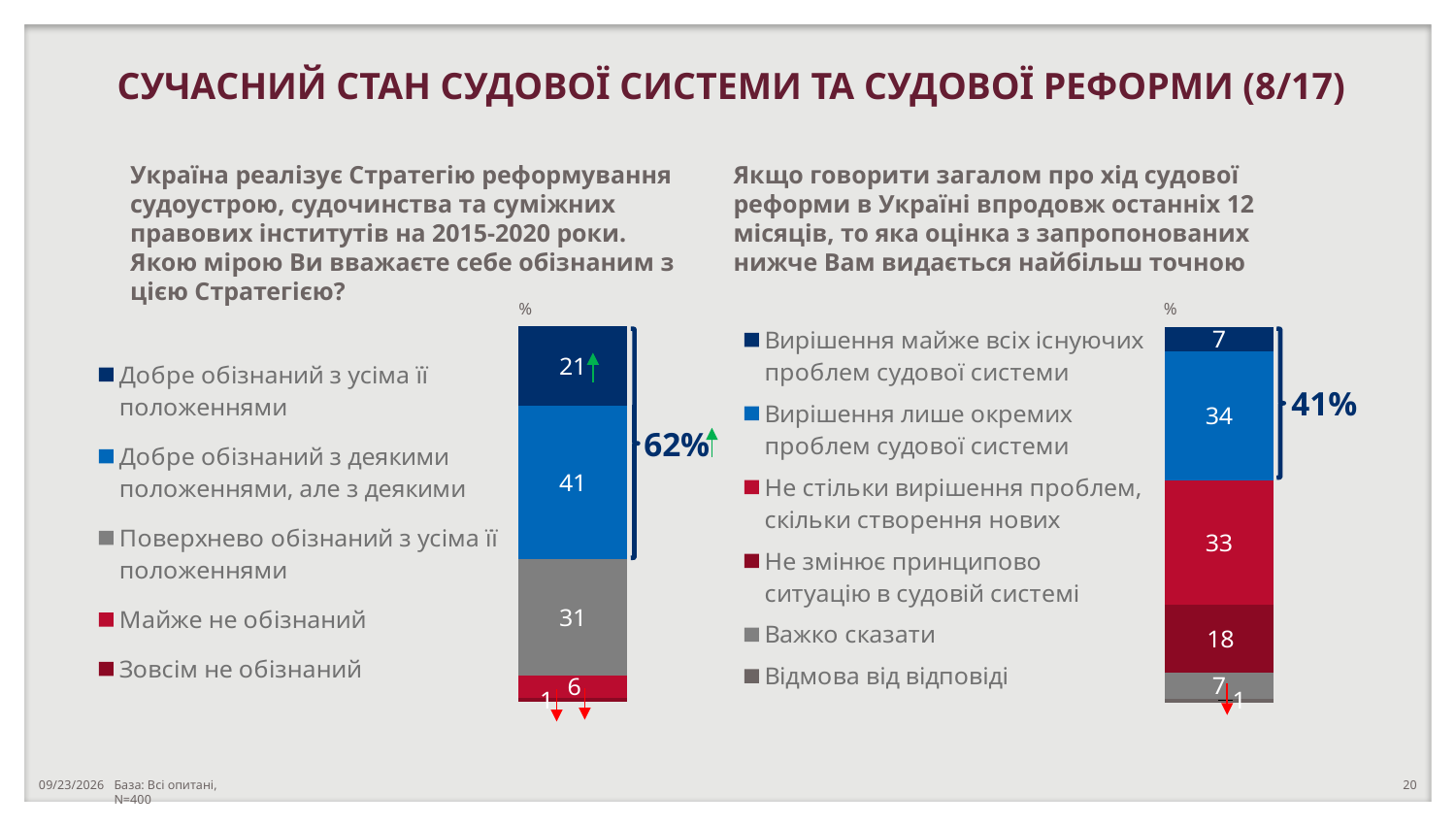
On the left chart, which category has the highest value? Добре обізнаний з деякими положеннями, але з деякими On the left chart, which category has the lowest value? Зовсім не обізнаний On the right chart, which is larger: the value for "Вирішення лише окремих проблем судової системи" or the value for "Не змінює принципово ситуацію в судовій системі"? Вирішення лише окремих проблем судової системи On the right chart, what is the value for "Не змінює принципово ситуацію в судовій системі"? 18 What type of chart is used on the left side of the slide? Stacked bar chart On the left chart, what is the value for "Добре обізнаний з деякими положеннями, але з деякими"? 41 On the left chart, what is the difference between the values for "Добре обізнаний з деякими положеннями, але з деякими" and "Добре обізнаний з усіма її положеннями"? 20 On the right chart, what is the value for "Не стільки вирішення проблем, скільки створення нових"? 33 On the left chart, what combined percentage is shown by the bracket next to the top two segments? 62% On the left chart, what is the value for "Поверхнево обізнаний з усіма її положеннями"? 31 On the right chart, what combined percentage is shown by the bracket next to the top two segments? 41% How many categories does the legend of the right chart list? 6